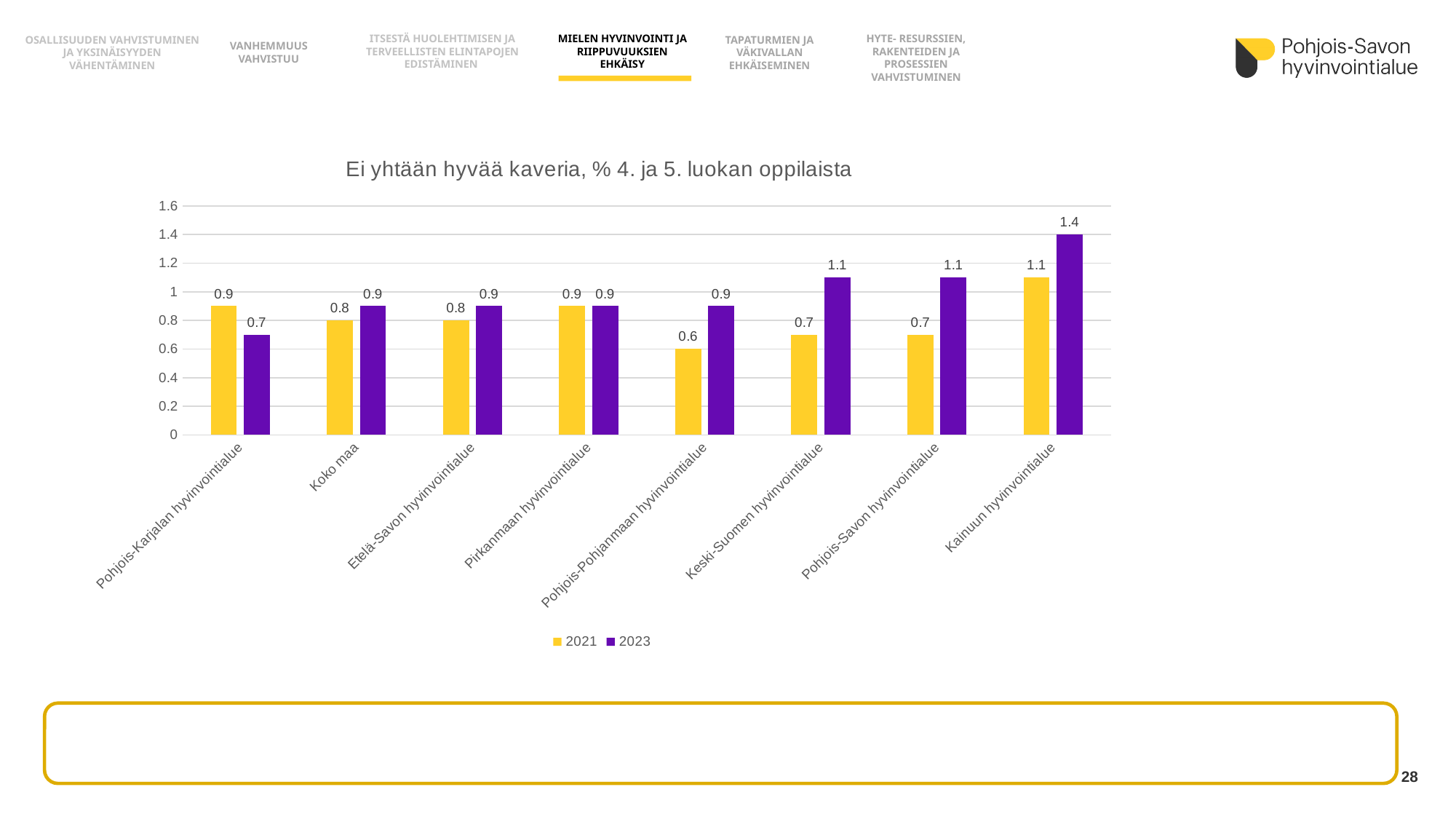
Which category has the highest 2023 value? Kainuun hyvinvointialue What is the 2021 value for Koko maa? 0.8 How many series does the legend list? 2 How many categories are shown on the x axis? 8 For Pohjois-Karjalan hyvinvointialue, which year has the larger value, 2021 or 2023? 2021 Is the 2023 value for Kainuun hyvinvointialue greater or less than 1.2? greater What is the 2021 value for Pohjois-Pohjanmaan hyvinvointialue? 0.6 What is the difference between the 2023 and 2021 values for Pohjois-Savon hyvinvointialue? 0.4 What kind of chart is shown on the slide? Bar chart What is the title of the chart? Ei yhtään hyvää kaveria, % 4. ja 5. luokan oppilaista What is the 2023 value for Kainuun hyvinvointialue? 1.4 Which category has the lowest 2021 value? Pohjois-Pohjanmaan hyvinvointialue